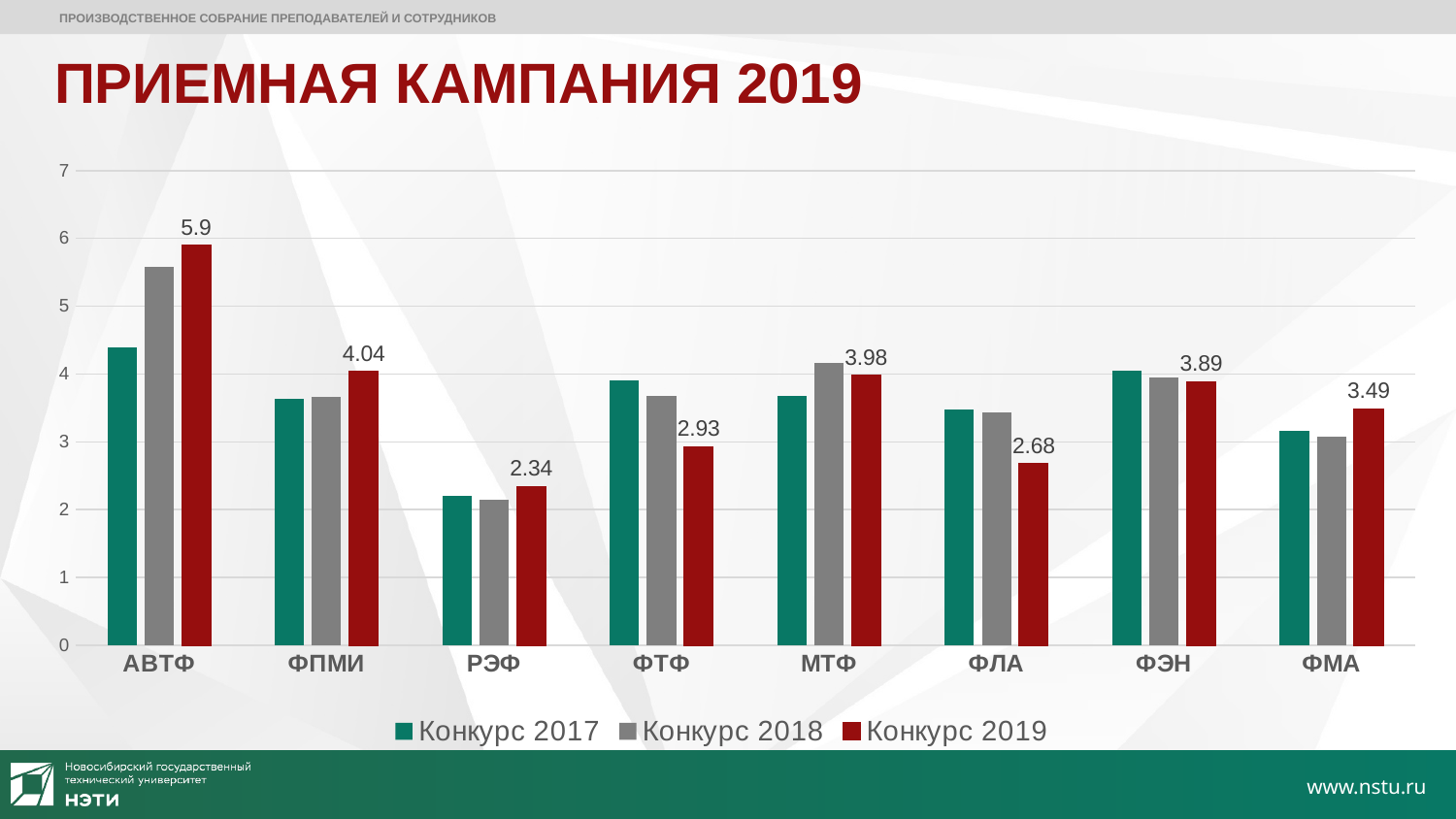
What is the value of Конкурс 2019 for АВТФ? 5.9 How many series does the legend list? 3 What is the value of Конкурс 2019 for РЭФ? 2.34 Is the Конкурс 2017 value for АВТФ greater or less than 4? greater What is the value of Конкурс 2019 for ФЭН? 3.89 For ФЛА, which is larger: Конкурс 2017 or Конкурс 2019? Конкурс 2017 Which is larger: the Конкурс 2019 value for ФТФ or for ФМА? ФМА How many categories are shown on the x axis? 8 What is the difference between the Конкурс 2019 values for АВТФ and ФПМИ? 1.86 Which category has the highest Конкурс 2019 value? АВТФ Which category has the lowest Конкурс 2019 value? РЭФ Is the Конкурс 2018 value for РЭФ greater or less than 3? less